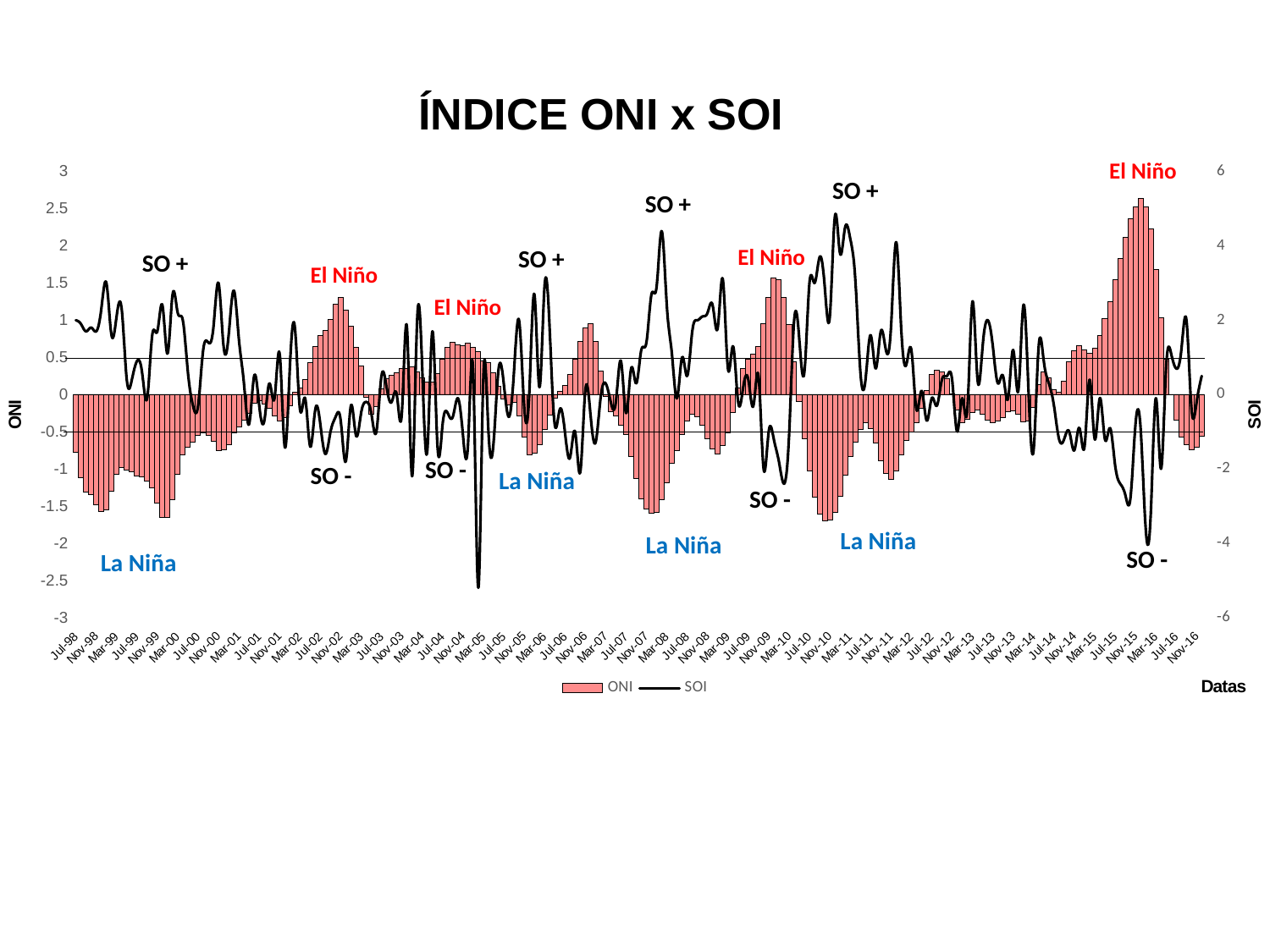
What is the title of the chart? ÍNDICE ONI x SOI Which series is drawn as bars and which as a line? ONI is bars, SOI is a line Around which date does the SOI line reach its lowest value? Mar-05 Around which date does the ONI series reach its highest value? Nov-15 Is the ONI value around Nov-02 greater or less than 1? greater Is the ONI value around Nov-99 greater or less than -1? less Is the SOI value around Mar-05 greater or less than -4? less Which is larger, the ONI value around Nov-15 or the ONI value around Nov-09? Nov-15 How many series does the legend list? 2 What kind of chart is this? Combined bar and line chart